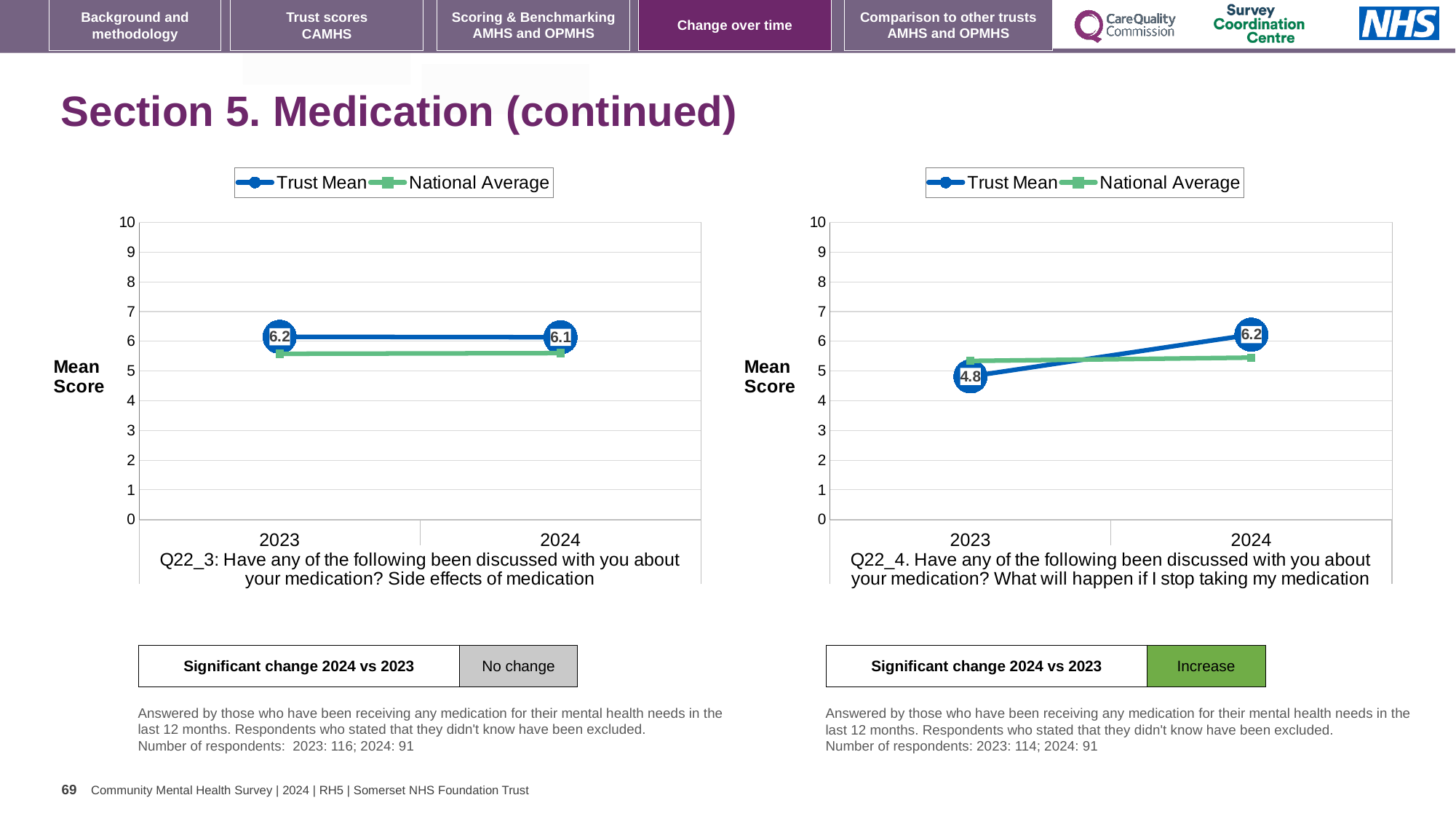
What kind of chart is the left chart (Q22_3)? line chart In the left chart (Q22_3), does the Trust Mean rise or fall from 2023 to 2024? fall How many series does the legend of the right chart (Q22_4) list? 2 In the left chart (Q22_3), what is the Trust Mean for 2023? 6.2 In the right chart (Q22_4), does the Trust Mean rise or fall from 2023 to 2024? rise In the right chart (Q22_4), what is the Trust Mean for 2023? 4.8 In the right chart (Q22_4), which is larger in 2023: the Trust Mean or the National Average? National Average How many years are shown on the x axis of the left chart (Q22_3)? 2 In the right chart (Q22_4), by how much did the Trust Mean change from 2023 to 2024? 1.4 In the right chart (Q22_4), what is the Trust Mean for 2024? 6.2 In the right chart (Q22_4), is the National Average for 2023 greater or less than 6? less In the left chart (Q22_3), what is the Trust Mean for 2024? 6.1